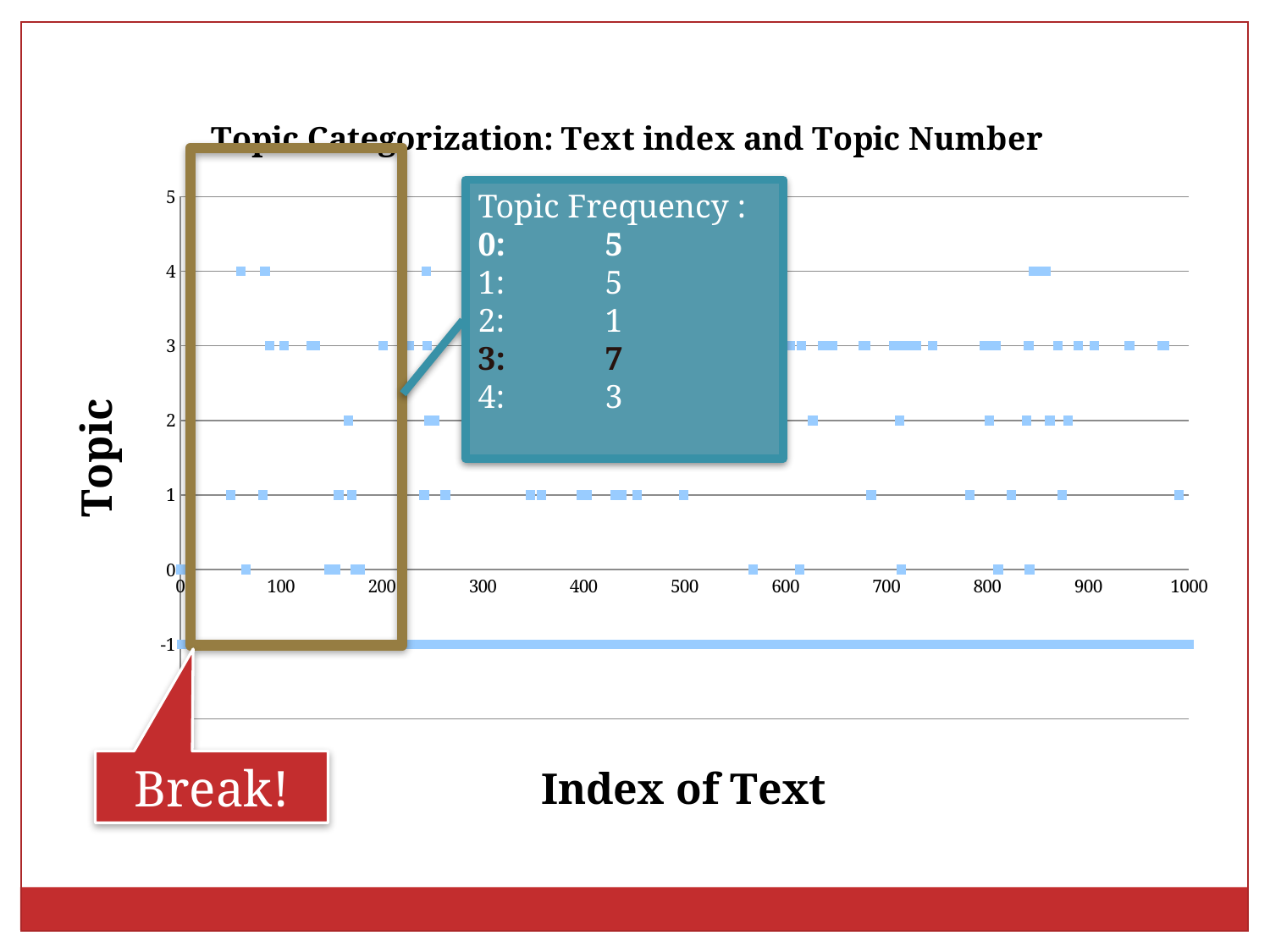
What is the label of the x axis of the chart? Index of Text What is the title of the chart? Topic Categorization: Text index and Topic Number How many labelled tick values are shown on the Topic (y) axis? 7 What is the lowest Topic value at which any points are plotted? -1 Is the largest value shown on the Index of Text axis greater or less than 500? greater What is the highest Topic value at which any points are plotted? 4 What kind of chart is shown on the slide? scatter chart